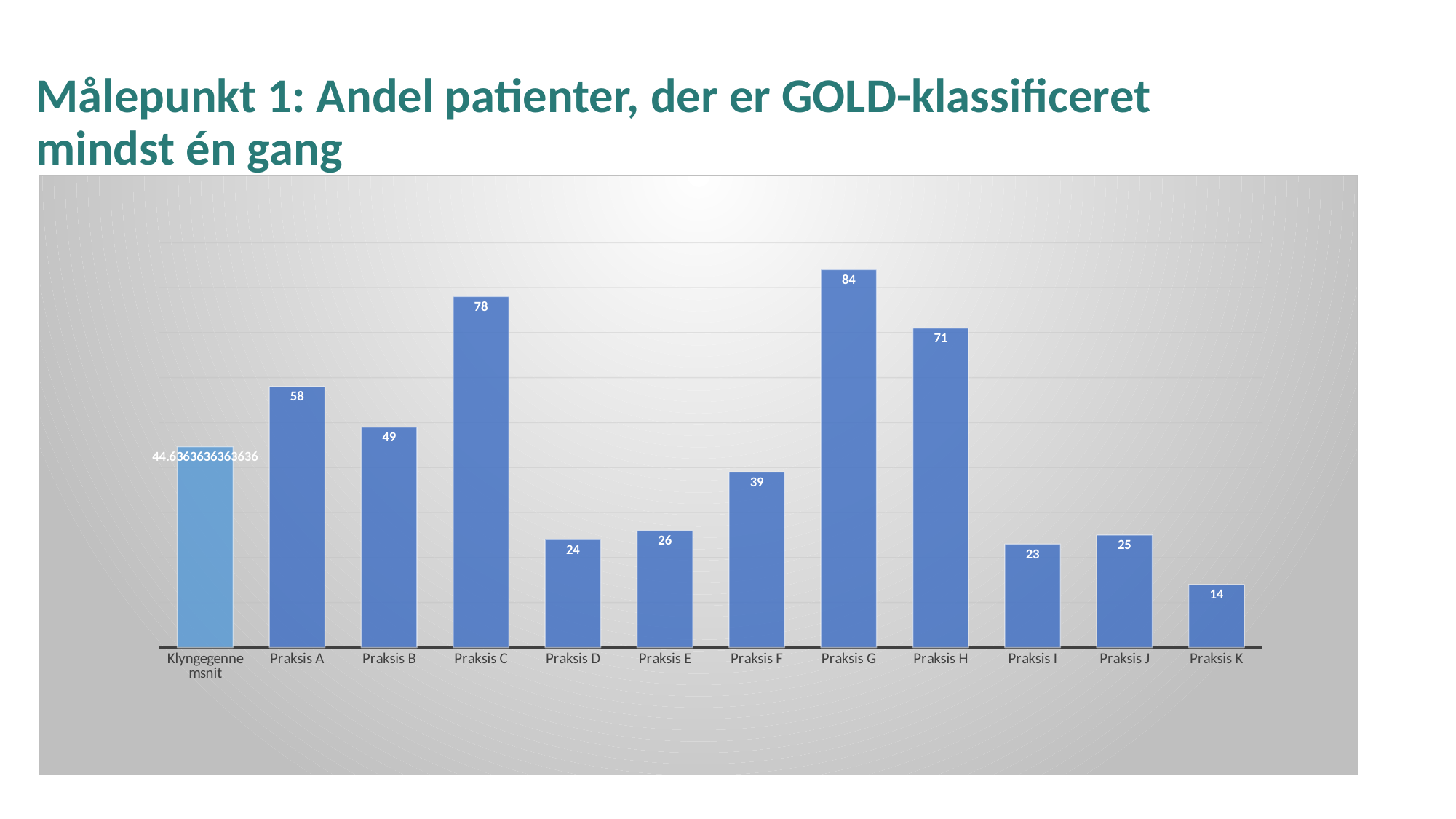
What is the difference between the values for Praksis A and Praksis B? 9 What is the value for Praksis K? 14 What is the title of the slide? Målepunkt 1: Andel patienter, der er GOLD-klassificeret mindst én gang What is the value for Praksis C? 78 Which category has the highest value? Praksis G Which category has the lowest value? Praksis K What is the difference between the values for Praksis G and Praksis H? 13 What is the value shown for Klyngegennemsnit? 44.6363636363636 How many categories are shown on the x axis? 12 What kind of chart is shown on the slide? Bar chart Which is larger, the value for Praksis D or the value for Praksis E? Praksis E Which is larger, the value for Praksis F or the value for Praksis J? Praksis F